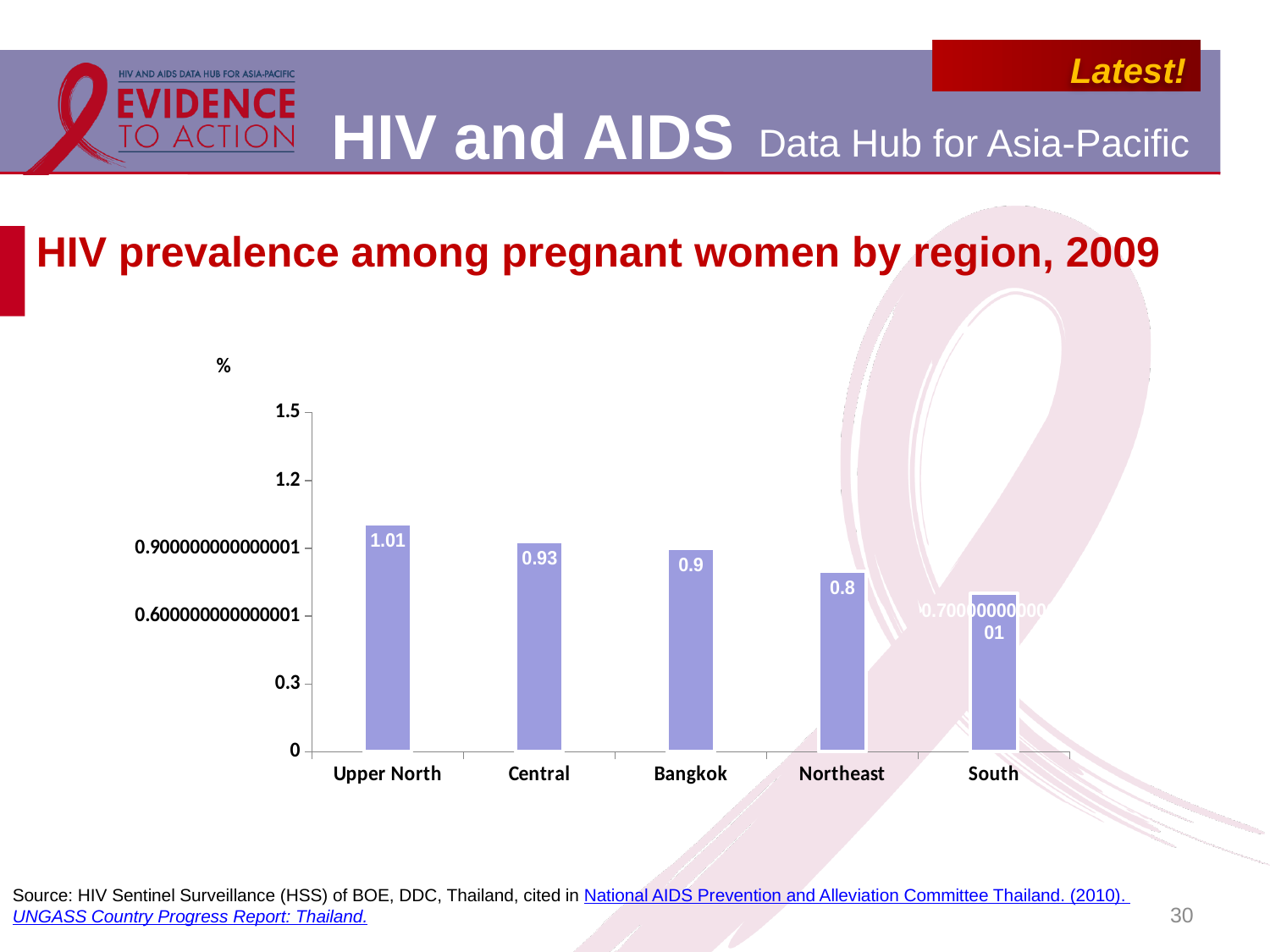
What is the difference in HIV prevalence between Upper North and Northeast? 0.21 What is the HIV prevalence among pregnant women in Central? 0.93 What is the HIV prevalence among pregnant women in Northeast? 0.8 What is the HIV prevalence among pregnant women in Bangkok? 0.9 Is the value for South greater or less than 0.9? less How many regions are shown in the chart? 5 Which region has the highest HIV prevalence among pregnant women? Upper North Which region has a higher HIV prevalence, Central or Northeast? Central What is the difference in HIV prevalence between Bangkok and Northeast? 0.1 What kind of chart is shown on the slide? Bar chart What is the HIV prevalence among pregnant women in Upper North? 1.01 Which region has the lowest HIV prevalence among pregnant women? South